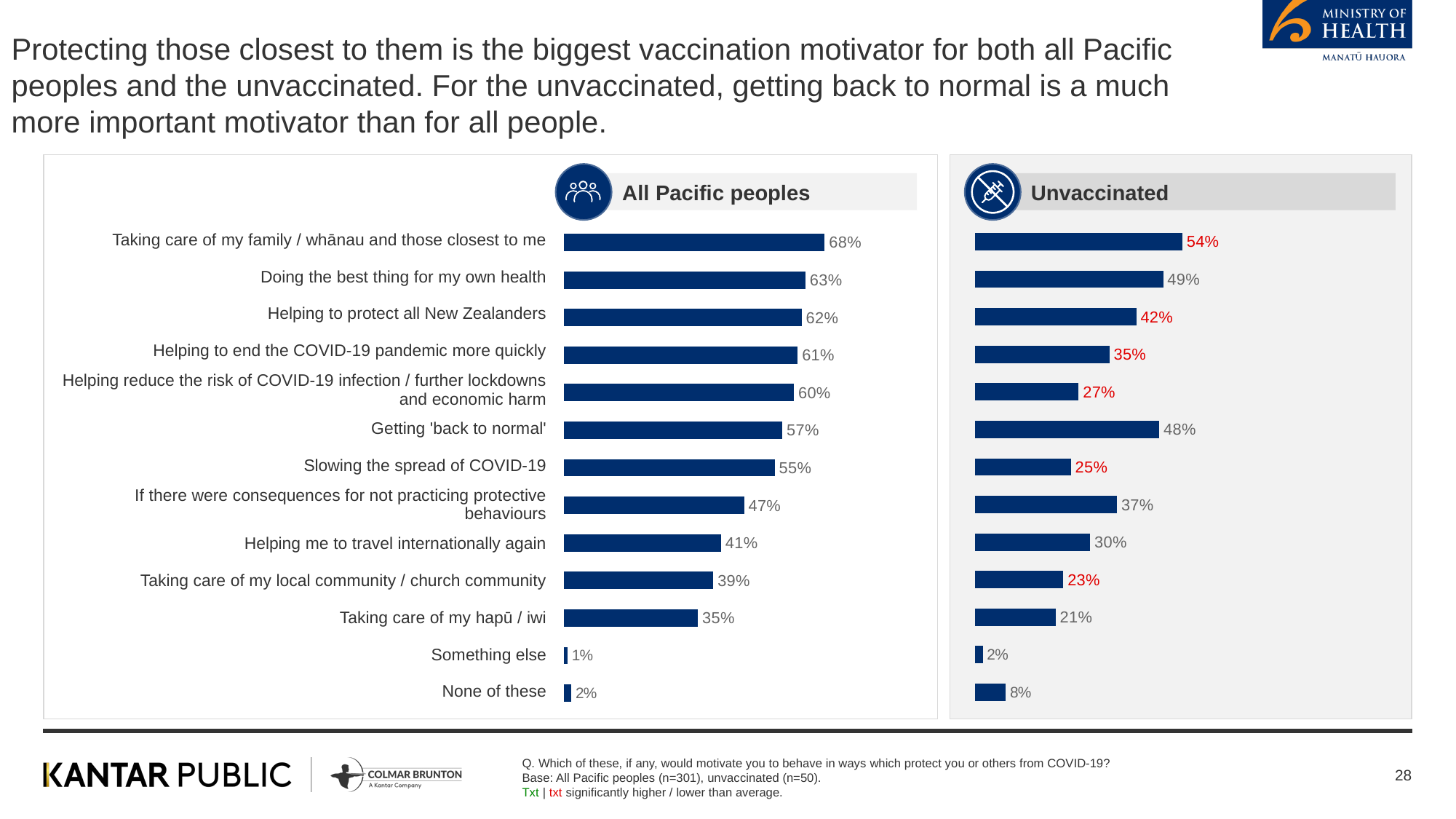
In the 'All Pacific peoples' chart, which category has the highest value? Taking care of my family / whānau and those closest to me What kind of chart is used on this slide? Bar chart In the 'Unvaccinated' chart, what is the value for 'Getting 'back to normal''? 48% How many categories are shown in the 'All Pacific peoples' chart? 13 What is the difference between the 'All Pacific peoples' and 'Unvaccinated' values for 'Slowing the spread of COVID-19'? 30 percentage points In the 'All Pacific peoples' chart, what is the value for 'Taking care of my family / whānau and those closest to me'? 68% In the 'Unvaccinated' chart, what is the value for 'None of these'? 8% What is the title of the chart on the right? Unvaccinated In the 'All Pacific peoples' chart, which category has the lowest value? Something else In the 'Unvaccinated' chart, which is larger: 'Doing the best thing for my own health' or 'Helping to protect all New Zealanders'? Doing the best thing for my own health In the 'Unvaccinated' chart, which category has the highest value? Taking care of my family / whānau and those closest to me In the 'Unvaccinated' chart, what is the value for 'Helping reduce the risk of COVID-19 infection / further lockdowns and economic harm'? 27%